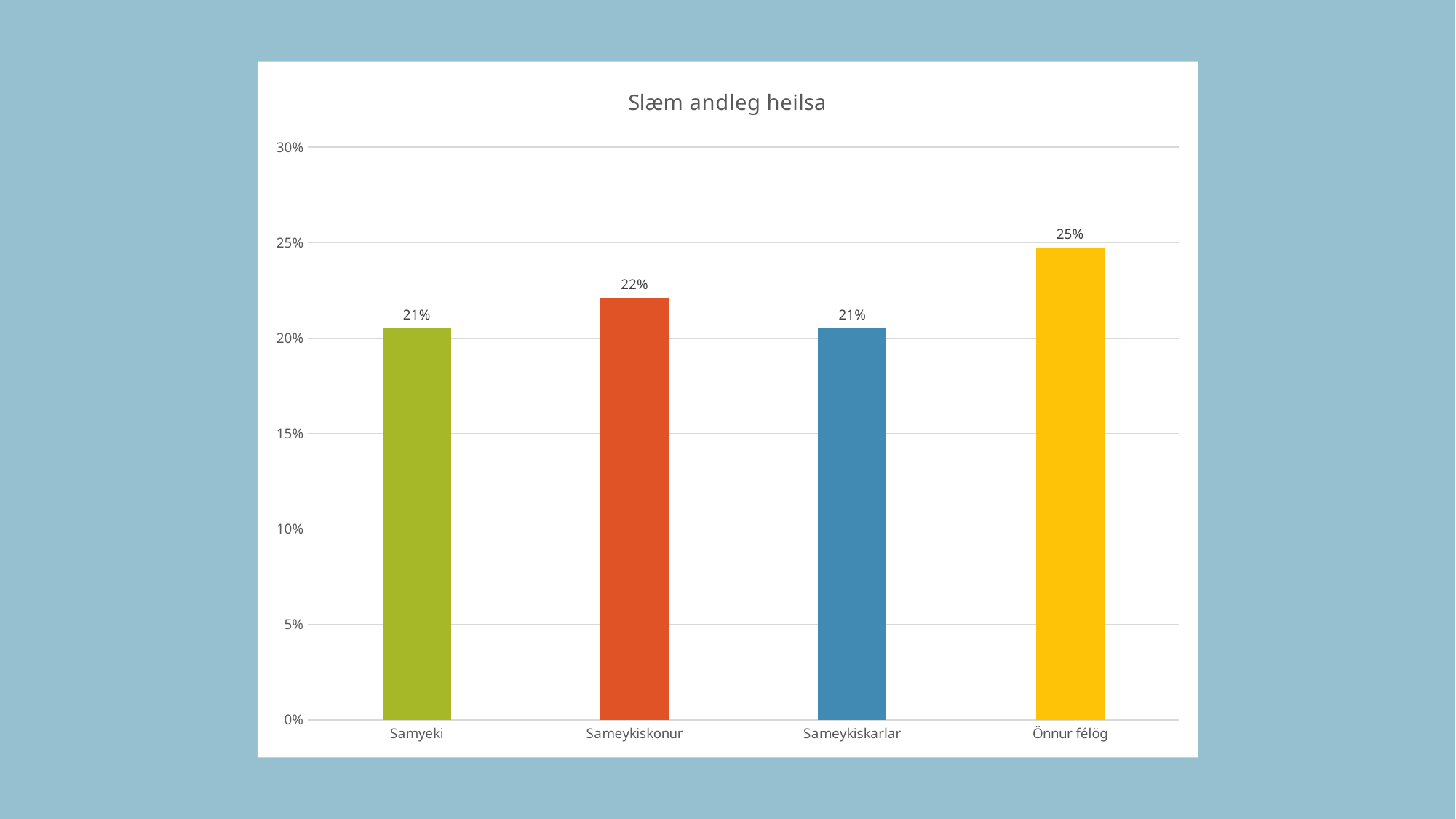
What is the difference between the values for Önnur félög and Samyeki? 4% What is the value for Samyeki? 21% What is the value for Önnur félög? 25% How many categories are shown on the x axis? 4 What kind of chart is shown on the slide? bar chart Which is larger, the value for Önnur félög or the value for Sameykiskarlar? Önnur félög What is the value for Sameykiskonur? 22% Which category has the highest value? Önnur félög What is the difference between the values for Önnur félög and Sameykiskonur? 3% What is the value for Sameykiskarlar? 21% What is the title of the chart? Slæm andleg heilsa Is the value for Sameykiskonur greater or less than 20%? greater